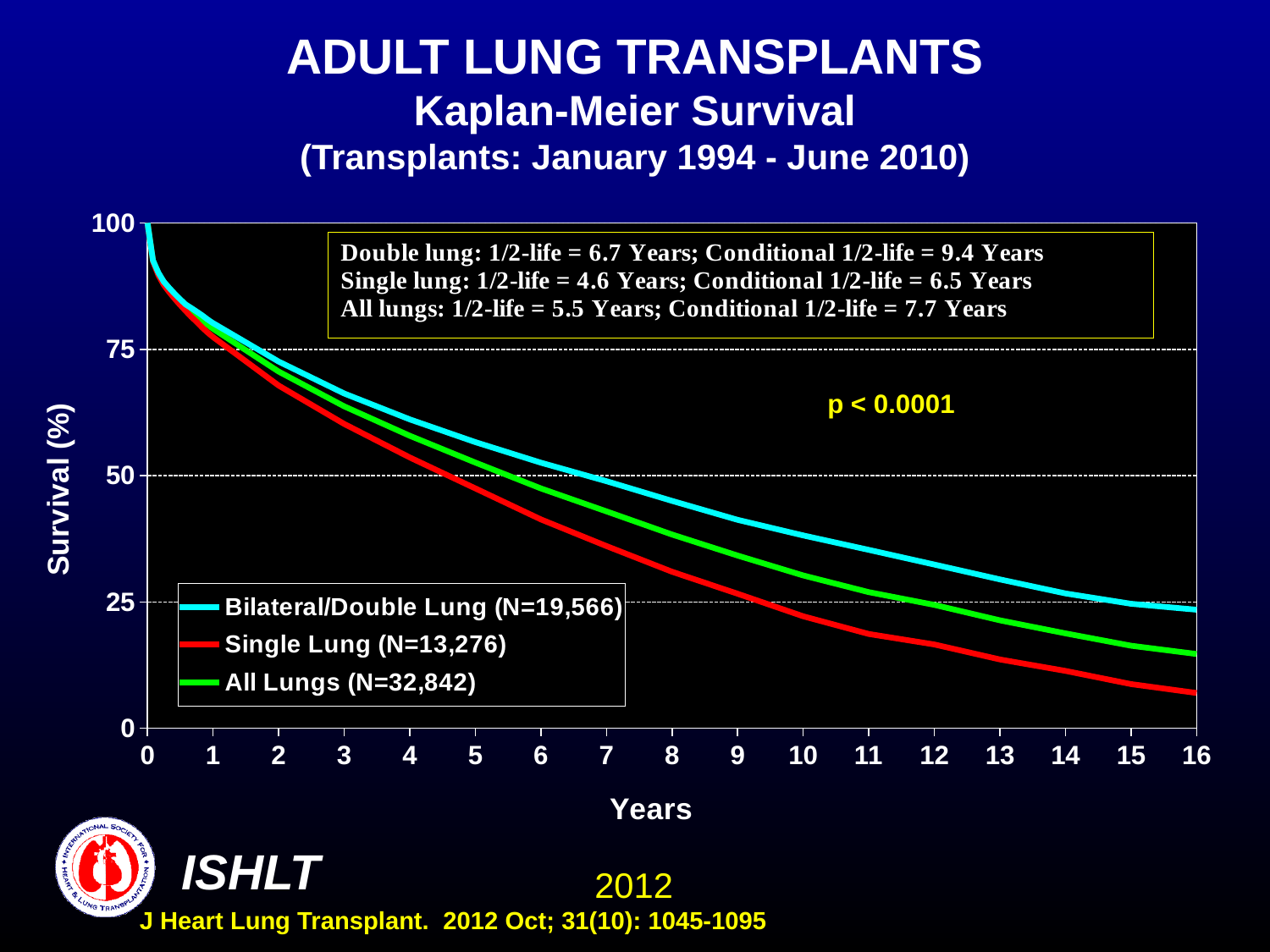
Is the survival for Bilateral/Double Lung at 12 years greater or less than 25? greater Do the survival curves rise or fall as years increase? fall What is the N for the All Lungs series in the legend? 32,842 What is the half-life for double lung transplants stated on the slide? 6.7 Years Which series has the lowest survival at 16 years? Single Lung Which series has the highest survival at 10 years: Bilateral/Double Lung or Single Lung? Bilateral/Double Lung What kind of chart is shown on the slide? line chart How many series does the legend list? 3 What is the conditional half-life for single lung transplants stated on the slide? 6.5 Years Is the survival for All Lungs at 2 years greater or less than 75? less Is the survival for Bilateral/Double Lung at 5 years greater or less than 50? greater